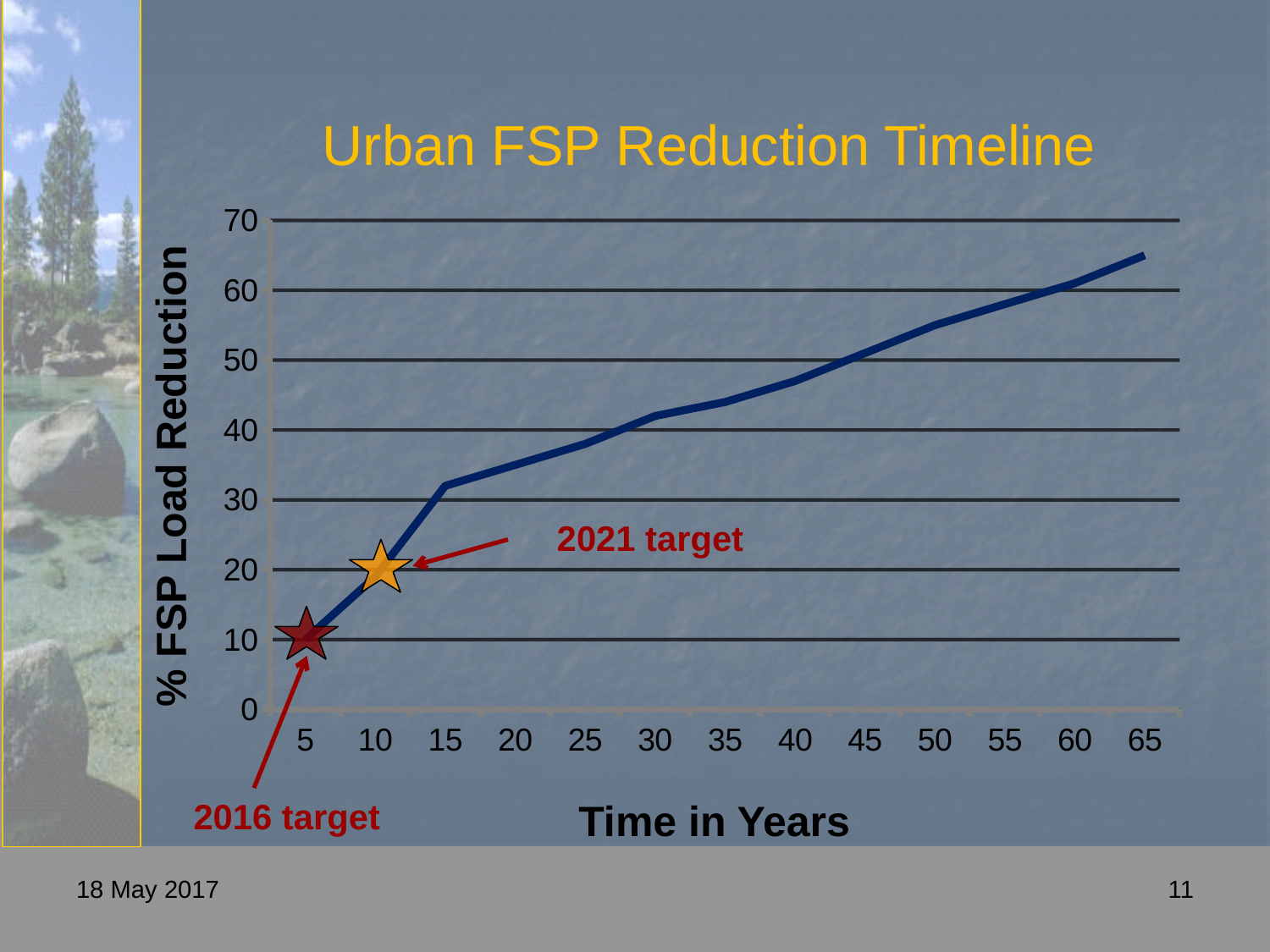
Which is larger, the % FSP load reduction at 30 years or at 60 years? 60 years Is the % FSP load reduction at 25 years greater or less than 40? less What is the title of the chart? Urban FSP Reduction Timeline Do the values rise or fall as time in years increases? rise Is the % FSP load reduction at 40 years greater or less than 50? less What is the label of the y axis? % FSP Load Reduction What % FSP load reduction does the 2021 target star mark on the y axis? 20 Is the % FSP load reduction at 15 years greater or less than 30? greater What % FSP load reduction does the 2016 target star mark on the y axis? 10 What kind of chart is shown on the slide? line chart